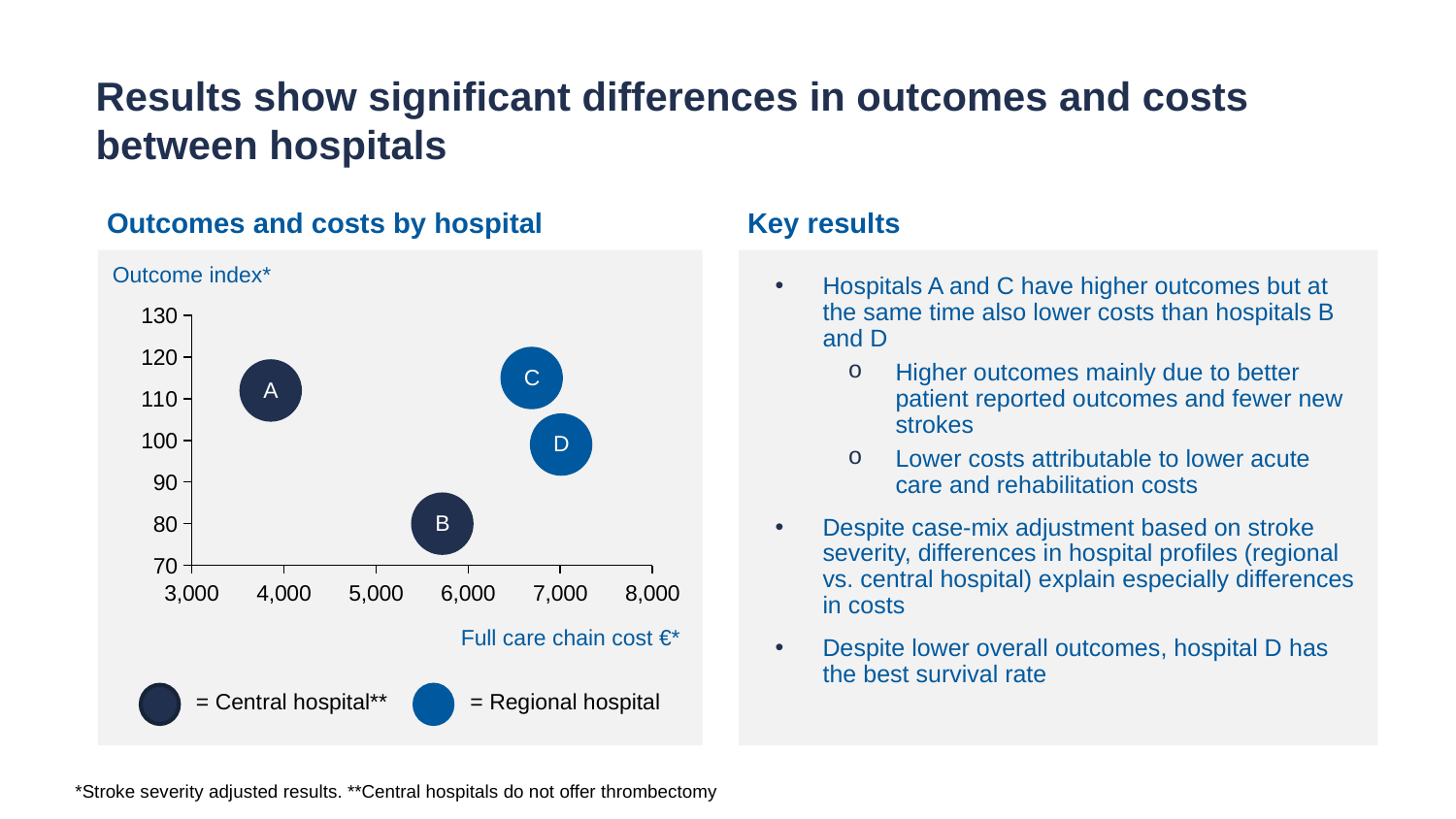
How many hospitals are plotted on the chart? 4 Which hospitals are marked as central hospitals in the chart? A and B Which hospital has the lowest outcome index? B Is the outcome index for hospital B greater or less than 90? less Is the full care chain cost for hospital A greater or less than 5,000? less Which hospital has a higher full care chain cost, A or B? B Is the outcome index for hospital A greater or less than 100? greater What kind of chart is shown under "Outcomes and costs by hospital"? Bubble chart Which hospital has a higher outcome index, B or D? D Which hospital has the lowest full care chain cost? A What does the x axis of the chart represent? Full care chain cost €*